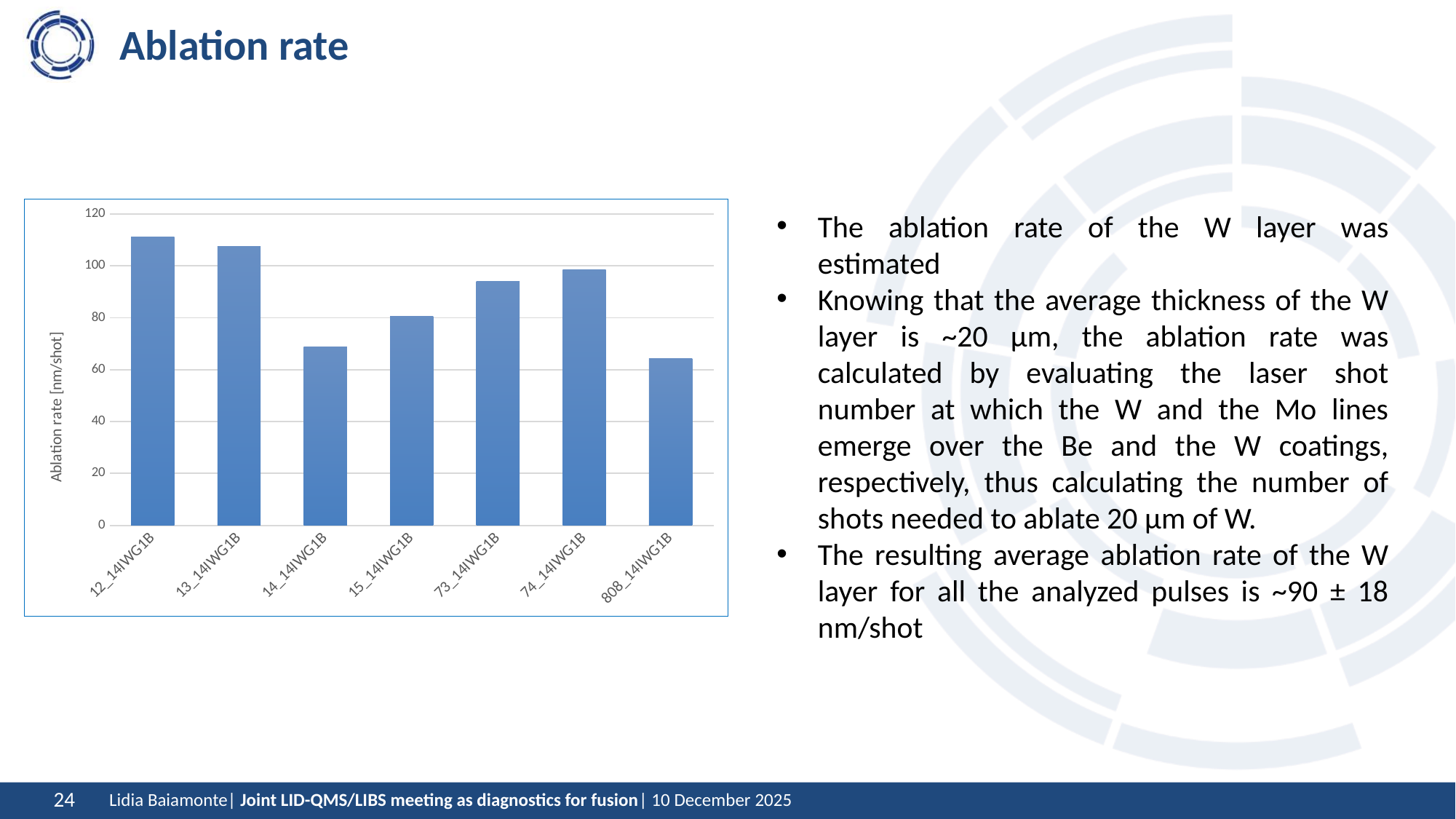
Is the ablation rate for 14_14IWG1B greater or less than 80? less How many categories (samples) are plotted on the x axis of the chart? 7 What is the label of the vertical axis of the chart? Ablation rate [nm/shot] Is the ablation rate for 808_14IWG1B greater or less than 60? greater Which sample has the highest ablation rate in the chart? 12_14IWG1B Which sample has the lowest ablation rate in the chart? 808_14IWG1B What kind of chart is shown on the slide? bar chart Is the ablation rate for 13_14IWG1B greater or less than 100? greater Which has a larger ablation rate, 15_14IWG1B or 808_14IWG1B? 15_14IWG1B Which has a larger ablation rate, 12_14IWG1B or 14_14IWG1B? 12_14IWG1B